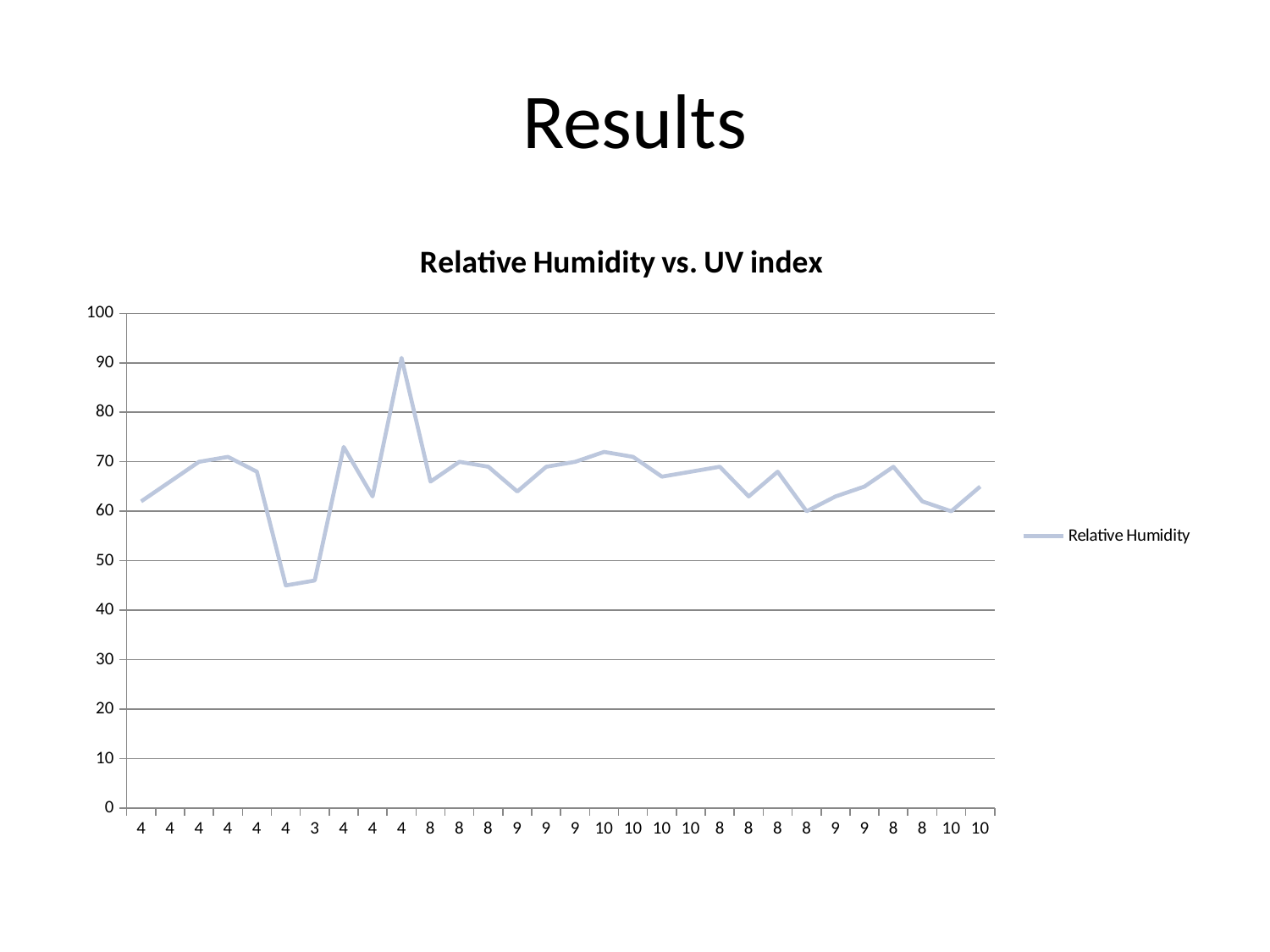
What is the name of the series shown in the legend? Relative Humidity What kind of chart is shown on the slide? line chart Is the highest value on the Relative Humidity line greater or less than 80? greater Is the last plotted value of Relative Humidity greater or less than 70? less How many data points are plotted on the line? 30 What is the title of the chart? Relative Humidity vs. UV index Does the Relative Humidity line rise or fall between the first and second points? rise Is the first plotted value of Relative Humidity greater or less than 70? less What is the maximum value shown on the vertical axis? 100 How many series does the legend list? 1